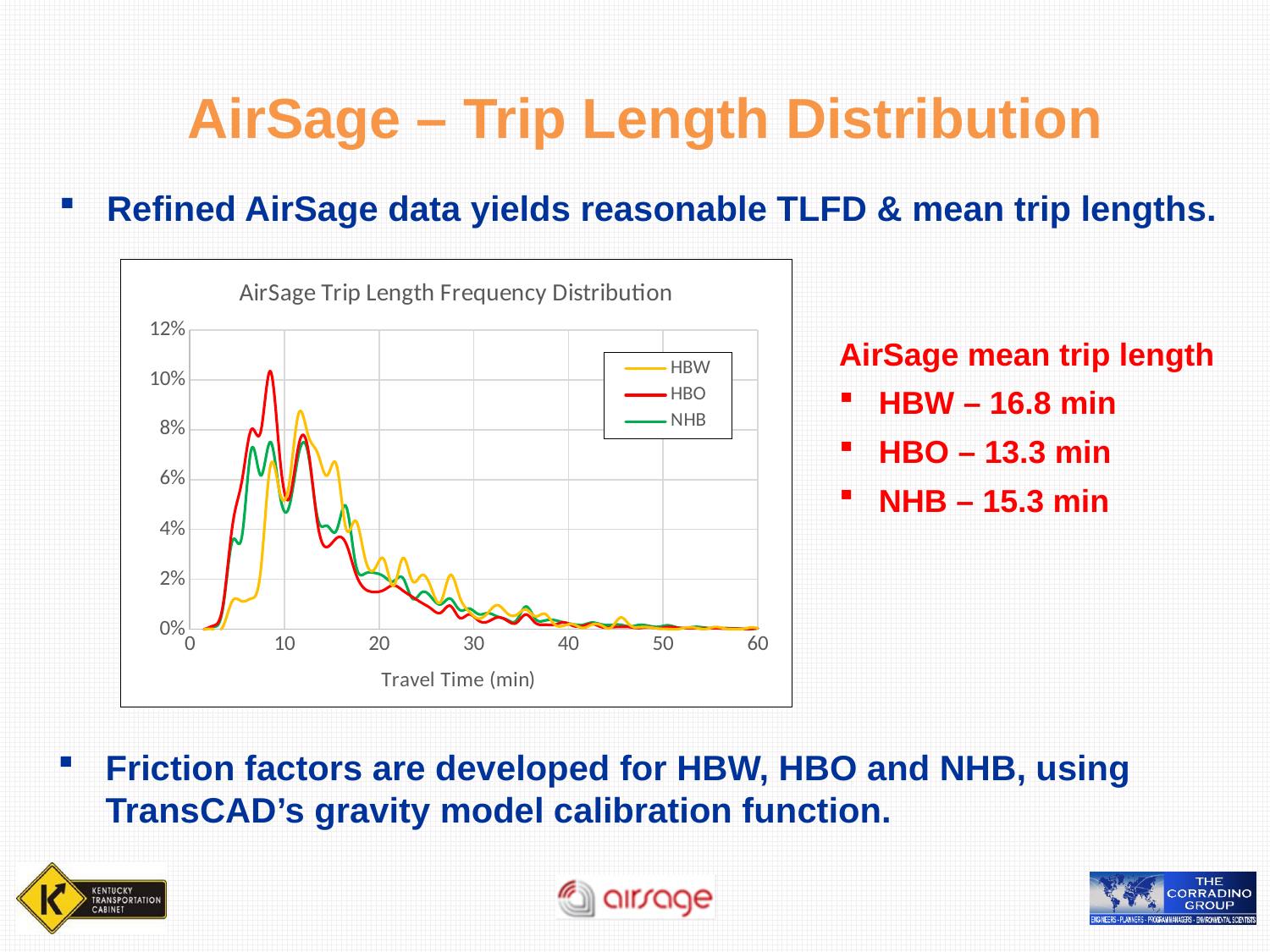
What kind of chart is shown on the slide? line chart Is the peak value of the NHB series greater or less than 10%? less How many series does the chart legend list? 3 Is the peak value of the HBW series greater or less than 10%? less Is the peak value of the HBO series greater or less than 8%? greater At a travel time of 5 minutes, which series has the larger value, HBW or HBO? HBO Which colour is used for the HBO series in the chart? red Do the series values generally rise or fall as travel time increases from 20 to 60 minutes? fall Which series reaches the highest peak value in the chart? HBO What is the maximum value shown on the chart's vertical axis? 12% What is the title of the chart? AirSage Trip Length Frequency Distribution